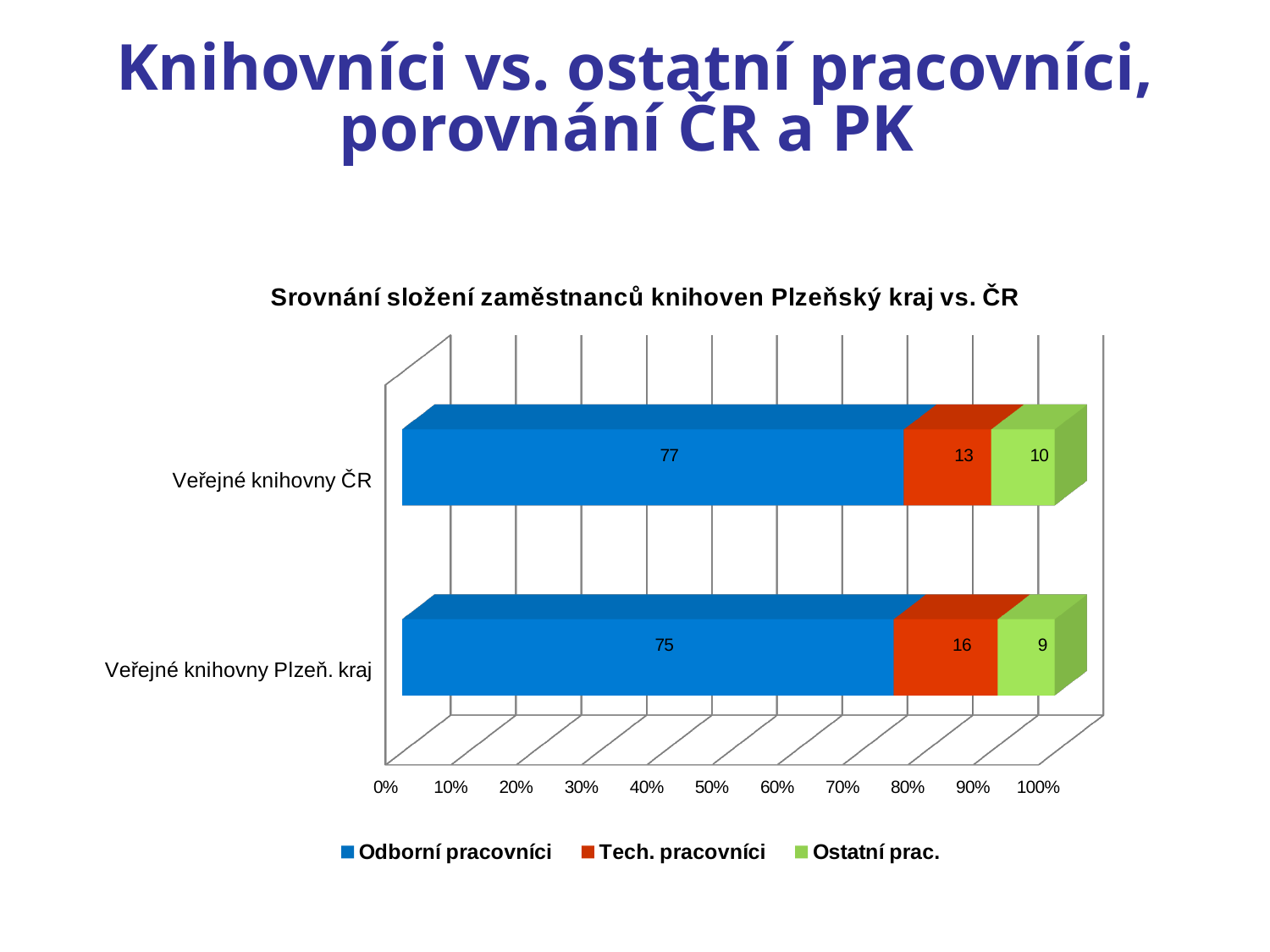
What is the difference between the Tech. pracovníci values for Veřejné knihovny Plzeň. kraj and Veřejné knihovny ČR? 3 What kind of chart is shown on the slide? Stacked bar chart What is the value for Odborní pracovníci in Veřejné knihovny ČR? 77 What is the value for Odborní pracovníci in Veřejné knihovny Plzeň. kraj? 75 What is the difference between the Odborní pracovníci values for Veřejné knihovny ČR and Veřejné knihovny Plzeň. kraj? 2 What is the value for Tech. pracovníci in Veřejné knihovny Plzeň. kraj? 16 What is the value for Ostatní prac. in Veřejné knihovny ČR? 10 What is the title of the chart? Srovnání složení zaměstnanců knihoven Plzeňský kraj vs. ČR How many categories are shown on the chart? 2 Which category has the higher value for Tech. pracovníci? Veřejné knihovny Plzeň. kraj How many series does the legend list? 3 What is the total of the stacked bar for Veřejné knihovny ČR? 100